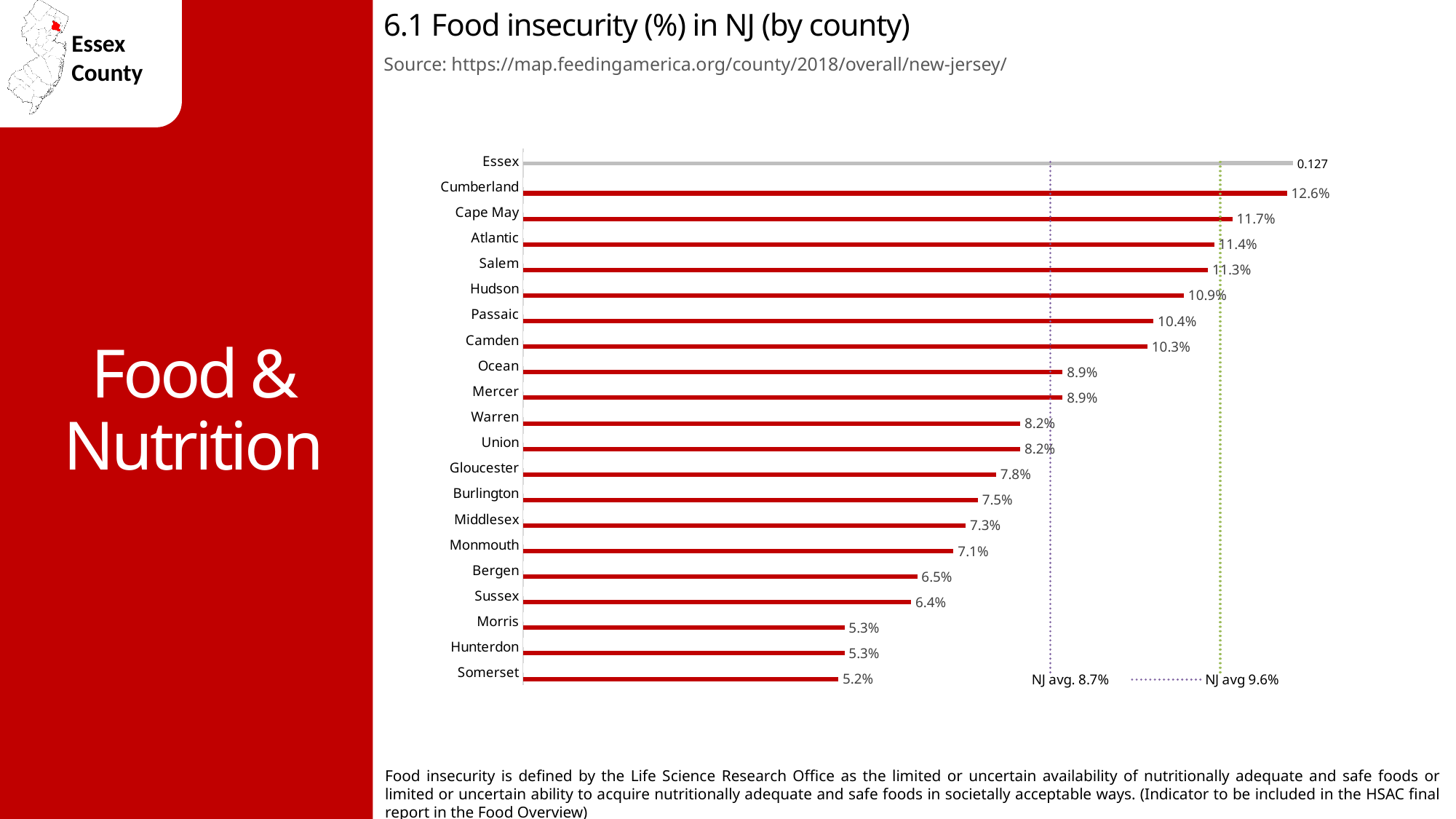
Which county has a higher food insecurity value, Cape May or Camden? Cape May What is the difference between the food insecurity values for Cumberland and Somerset? 7.4% What two NJ average values are marked by the dotted reference lines on the chart? 8.7% and 9.6% Which county has the lowest food insecurity value on the chart? Somerset What is the food insecurity value shown for Cumberland county? 12.6% What is the food insecurity value shown for Hudson county? 10.9% What is the difference between the food insecurity values for Hudson and Passaic? 0.5% Which county has a higher food insecurity value, Bergen or Middlesex? Middlesex How many counties are listed on the chart? 21 What kind of chart is shown on the slide? Bar chart What value is printed next to the Essex bar? 0.127 Which county has the longest bar on the chart? Essex